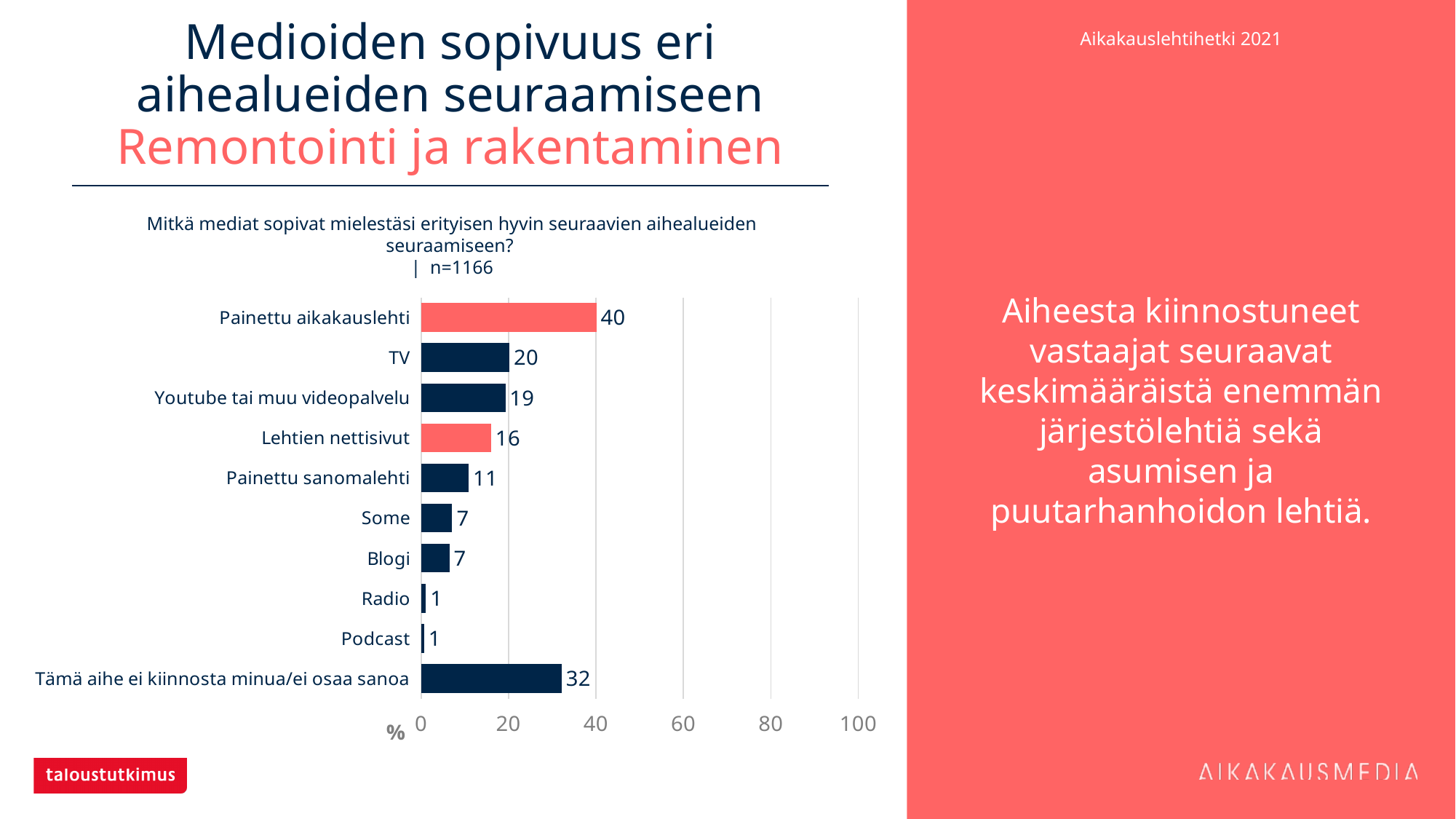
How many categories are shown in the chart? 10 Which categories are shown with red bars? Painettu aikakauslehti and Lehtien nettisivut Which is larger, the value for TV or the value for Lehtien nettisivut? TV What is the difference between the values for TV and Youtube tai muu videopalvelu? 1 What kind of chart is shown on the slide? bar chart Is the value for Tämä aihe ei kiinnosta minua/ei osaa sanoa greater or less than 20? greater What is the value for Lehtien nettisivut? 16 What is the value for Painettu aikakauslehti? 40 What is the difference between the values for Painettu aikakauslehti and Painettu sanomalehti? 29 What is the sample size (n) stated above the chart? n=1166 What is the value for Tämä aihe ei kiinnosta minua/ei osaa sanoa? 32 Which category has the highest value? Painettu aikakauslehti